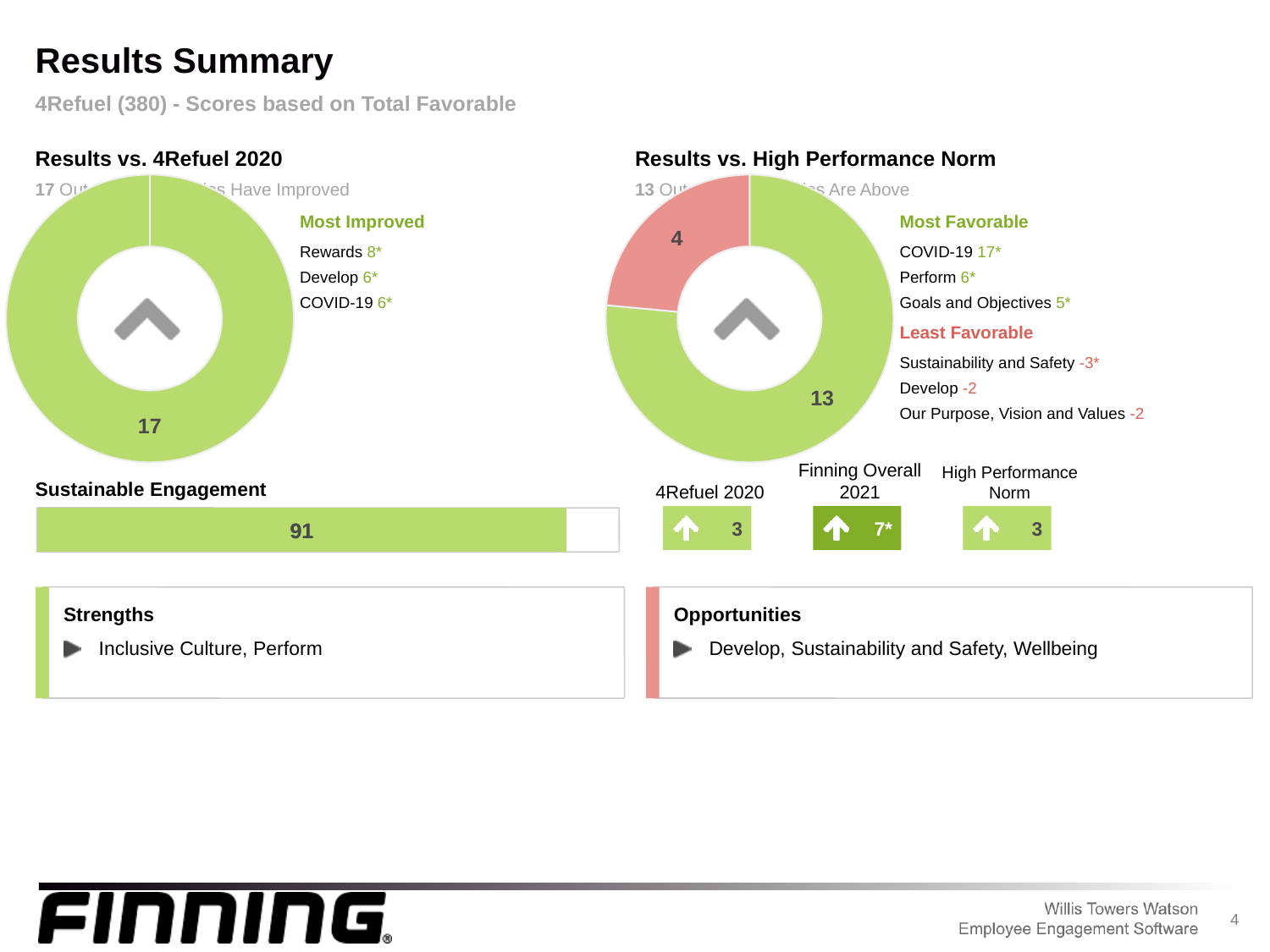
In the "Results vs. High Performance Norm" donut chart, which segment is larger, the green one or the red one? green In the "Results vs. High Performance Norm" donut chart, what colour is the smaller segment? red How many segments does the "Results vs. 4Refuel 2020" donut chart have? 1 In the "Results vs. High Performance Norm" donut chart, what is the total of the two segments? 17 In the "Results vs. High Performance Norm" donut chart, what is the difference between the green segment value and the red segment value? 9 In the "Results vs. High Performance Norm" donut chart, what value is shown on the green segment? 13 How many segments does the "Results vs. High Performance Norm" donut chart have? 2 What value is shown on the "Sustainable Engagement" bar? 91 What kind of chart is used for "Sustainable Engagement"? bar chart In the "Results vs. High Performance Norm" donut chart, what value is shown on the red segment? 4 In the "Results vs. 4Refuel 2020" donut chart, what value is shown on the green segment? 17 What kind of chart is shown under "Results vs. High Performance Norm"? donut chart